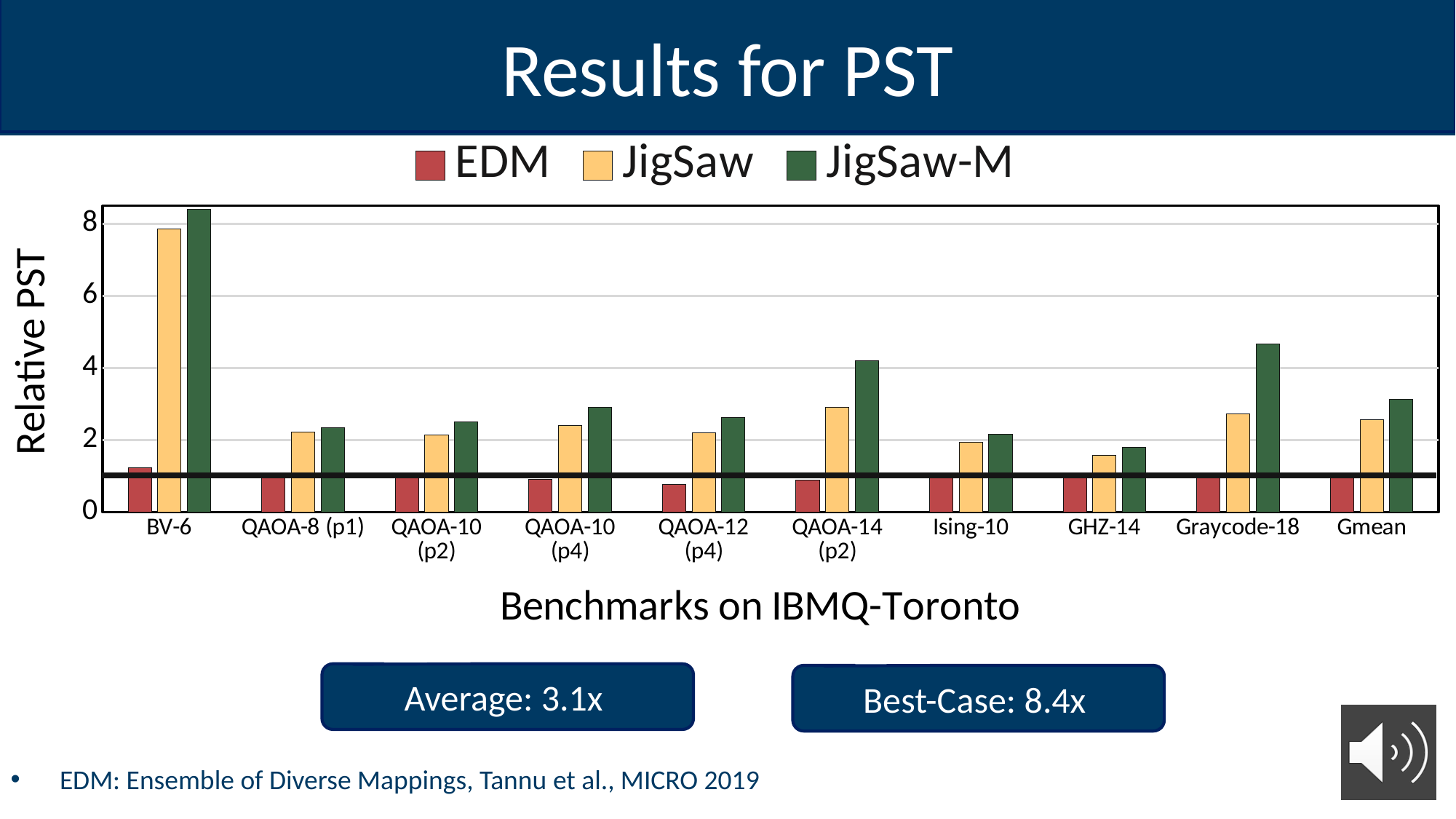
How many series does the legend list? 3 Is the JigSaw-M value for Graycode-18 greater or less than 4? greater Which is larger: the JigSaw value for Ising-10 or the JigSaw value for GHZ-14? Ising-10 How many benchmark categories are shown on the x axis? 10 Is the JigSaw value for BV-6 greater or less than 6? greater What kind of chart is shown on the slide? bar chart Which benchmark has the highest JigSaw-M bar? BV-6 Which benchmark has the lowest JigSaw-M bar? GHZ-14 Is the EDM value for QAOA-12 (p4) greater or less than 2? less What is the title of the y axis? Relative PST For QAOA-14 (p2), which is larger: the JigSaw bar or the JigSaw-M bar? JigSaw-M